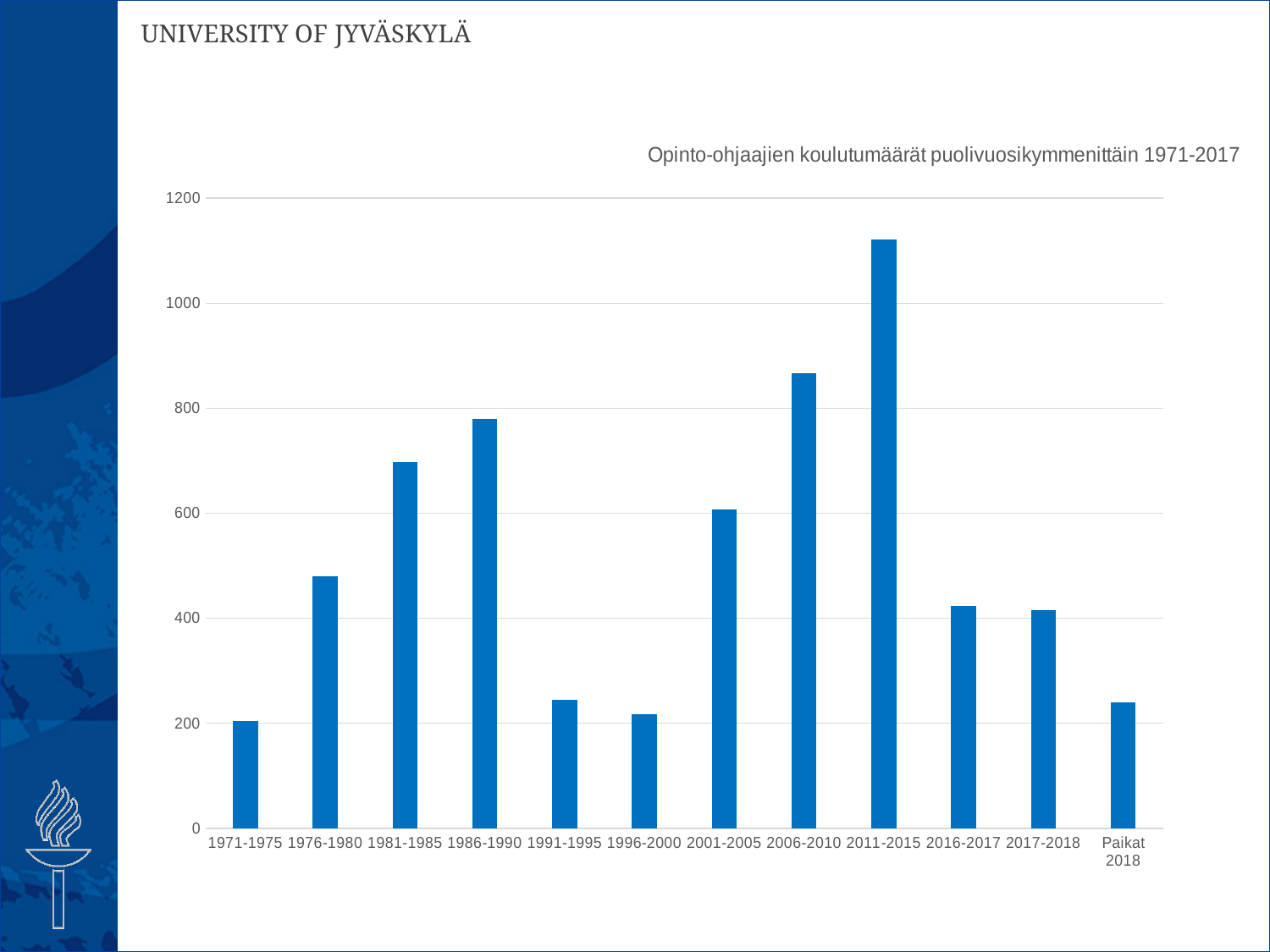
Which is larger, the value for 2001-2005 or the value for 1996-2000? 2001-2005 Do the values rise or fall from 1971-1975 to 1986-1990? rise What kind of chart is shown on the slide? bar chart Is the value for 1991-1995 greater or less than 400? less Is the value for 2011-2015 greater or less than 1000? greater What is the title of the chart? Opinto-ohjaajien koulutumäärät puolivuosikymmenittäin 1971-2017 How many categories are shown on the x axis of the chart? 12 Which category has the highest bar? 2011-2015 Is the value for 2006-2010 greater or less than 800? greater Which is larger, the value for 2006-2010 or the value for 1986-1990? 2006-2010